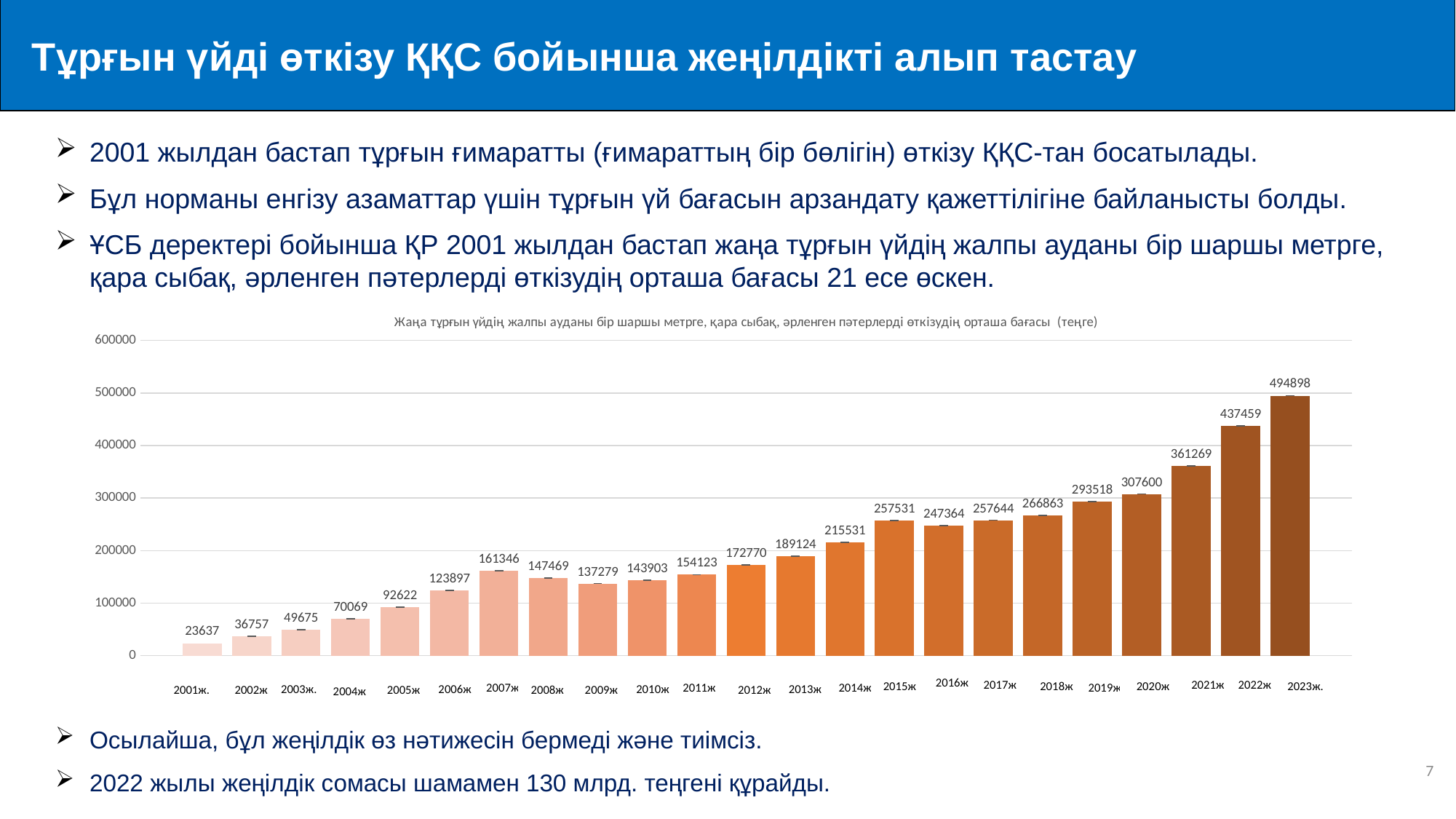
Which year has the highest value? 2023ж. What is the value for 2001ж.? 23637 Do the values generally rise or fall from 2001ж. to 2023ж.? rise Is the value for 2014ж greater or less than 200000? greater What is the value for 2023ж.? 494898 What is the difference between the values for 2022ж and 2021ж? 76190 Which year has the lowest value? 2001ж. What is the value for 2015ж? 257531 What kind of chart is shown on the slide? bar chart What is the difference between the values for 2023ж. and 2022ж? 57439 Which is larger, the value for 2007ж or the value for 2008ж? 2007ж How many years are shown on the chart? 23